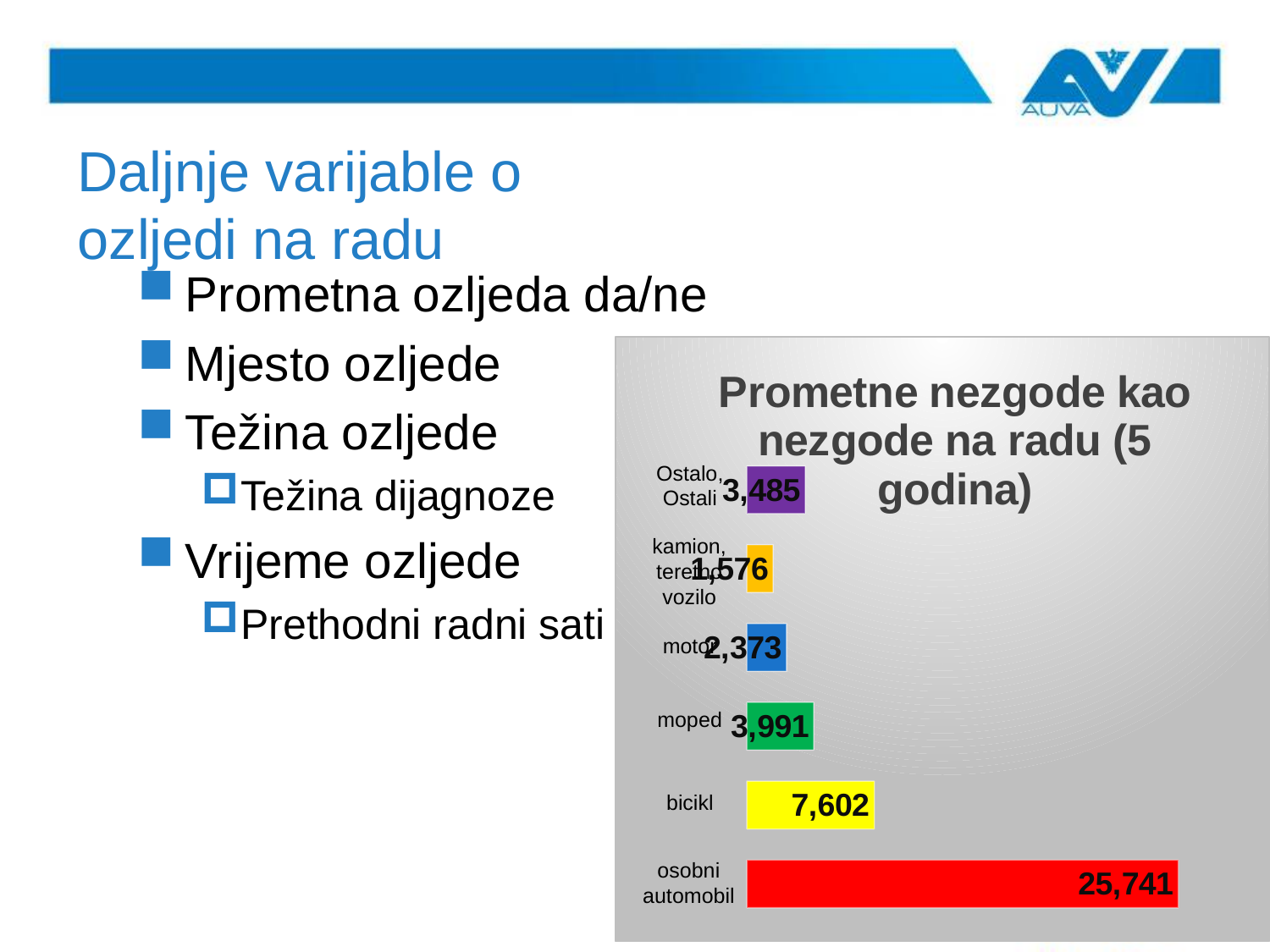
Which category has the highest value? osobni automobil Which is larger, the value for moped or the value for motor? moped What is the title of the chart? Prometne nezgode kao nezgode na radu (5 godina) How many categories are shown in the chart? 6 What is the value for osobni automobil? 25,741 What is the value for motor? 2,373 What is the value for kamion, teretno vozilo? 1,576 What is the value for moped? 3,991 What type of chart is shown on the slide? bar chart What is the value for bicikl? 7,602 What is the difference between the values for osobni automobil and bicikl? 18,139 Which category has the lowest value? kamion, teretno vozilo